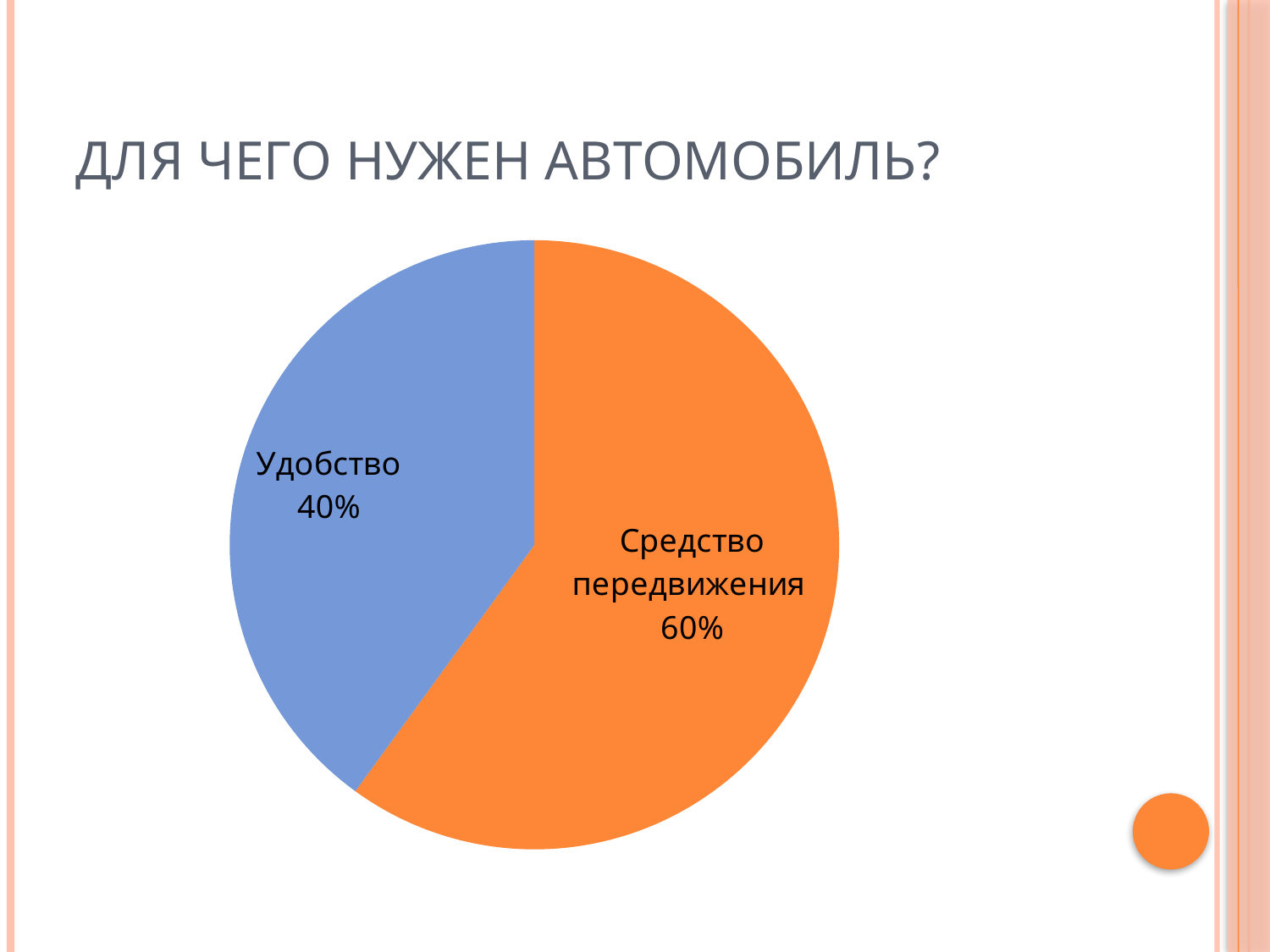
What share of the pie does "Средство передвижения" have? 60% What is the difference in percentage points between "Средство передвижения" and "Удобство"? 20% What is the title of the slide containing the pie chart? ДЛЯ ЧЕГО НУЖЕН АВТОМОБИЛЬ? What is the total of the two slices shown in the pie chart? 100% What share of the pie does "Удобство" have? 40% What kind of chart is shown on the slide? pie chart Which is larger, "Удобство" or "Средство передвижения"? Средство передвижения What colour is the "Удобство" slice? blue Which slice of the pie is the smallest? Удобство How many slices does the pie chart have? 2 Which slice of the pie is the largest? Средство передвижения